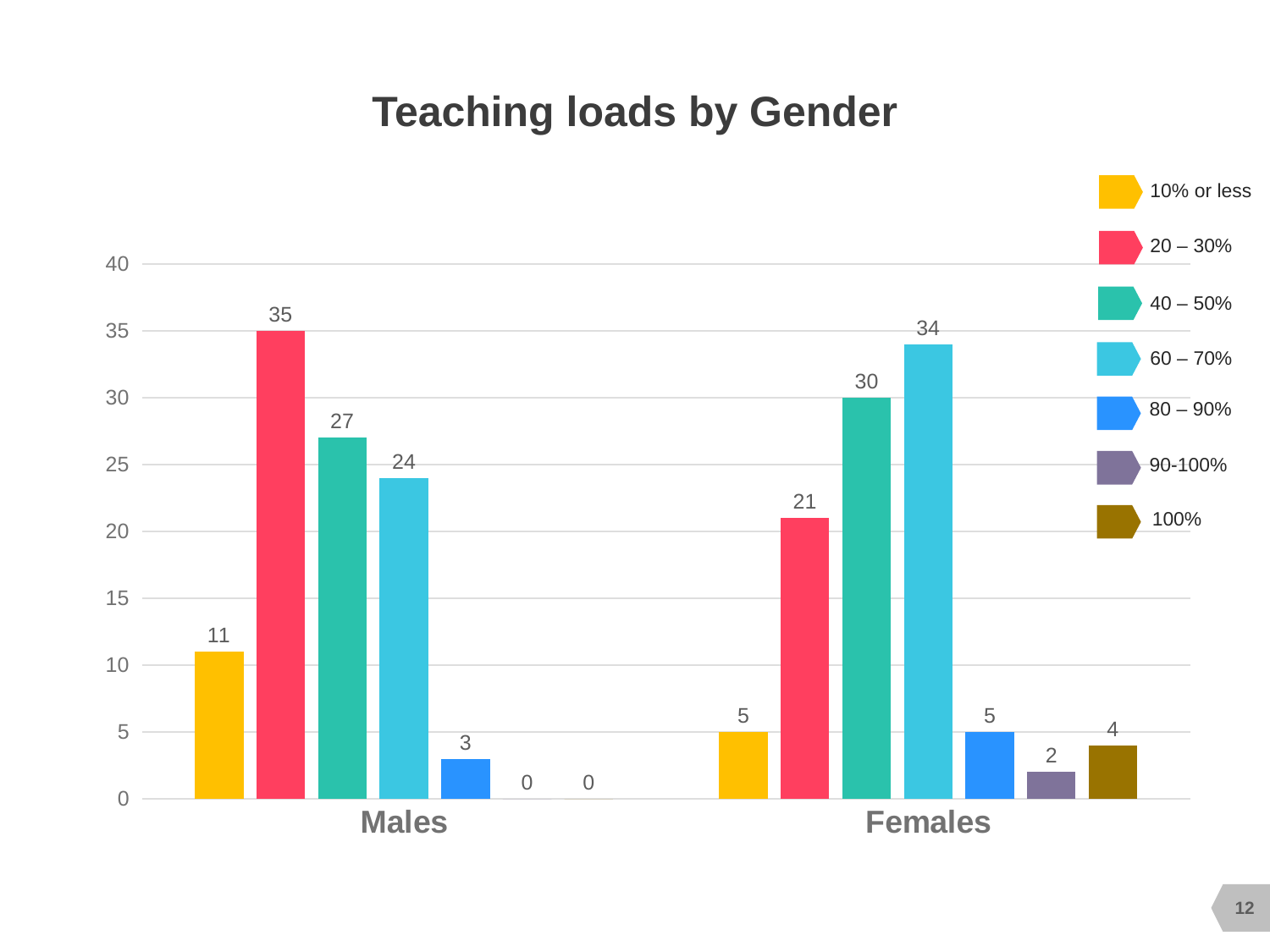
How many series does the legend list? 7 Which is larger: the Males value or the Females value in the 40 – 50% series? Females What is the title of the chart? Teaching loads by Gender What is the value for Females in the 60 – 70% series? 34 What is the value for Females in the 90-100% series? 2 What is the value for Males in the 20 – 30% series? 35 How many categories are shown on the x axis? 2 Which series has the highest value for Females? 60 – 70% Which series has the highest value for Males? 20 – 30% What kind of chart is shown on the slide? Bar chart What is the value for Males in the 10% or less series? 11 What is the difference between the Males and Females values in the 20 – 30% series? 14